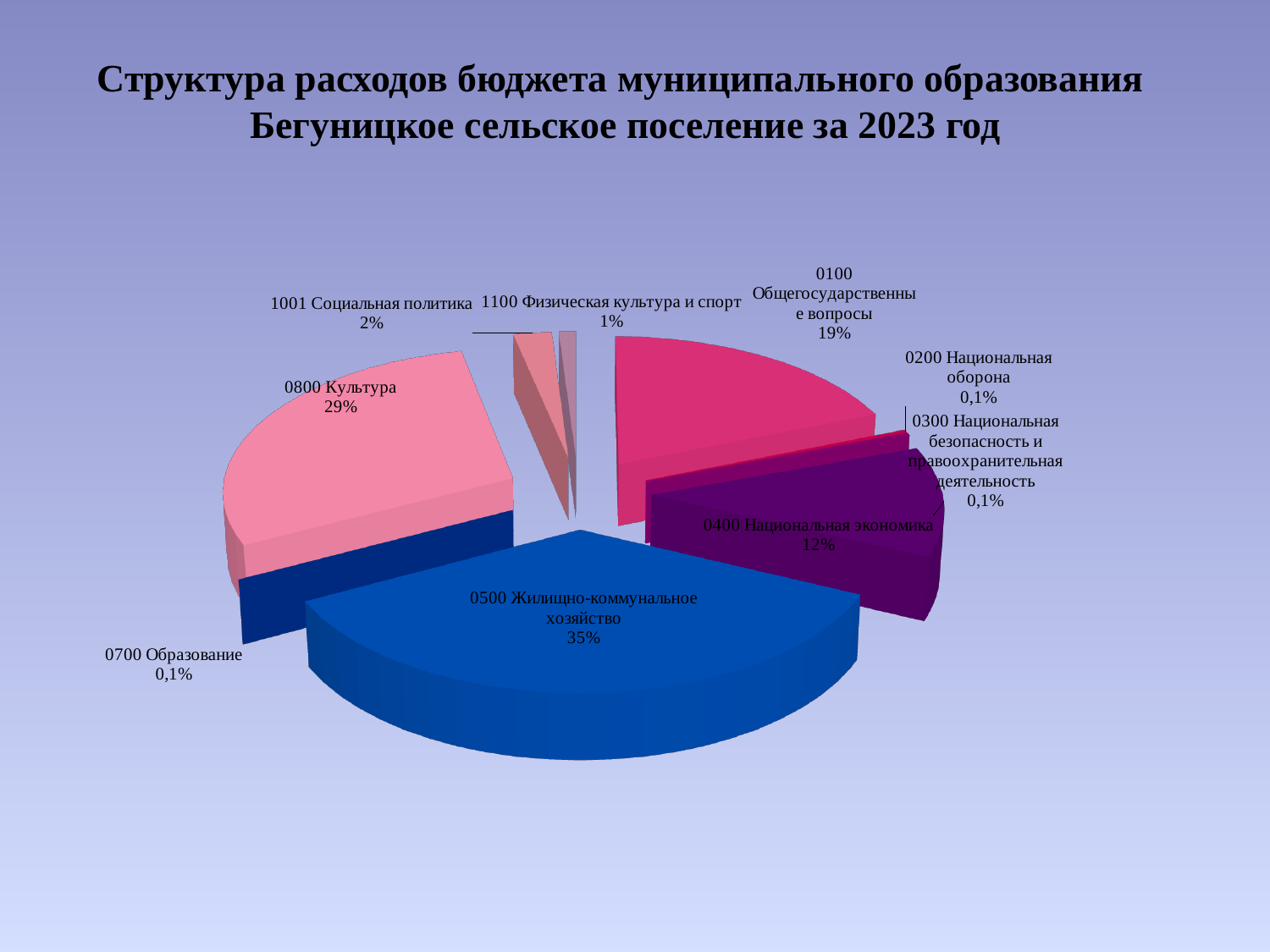
Which category has the largest share of the pie? 0500 Жилищно-коммунальное хозяйство What is the value shown for 0100 Общегосударственные вопросы? 19% What type of chart is shown on the slide? Pie chart What is the value shown for 0200 Национальная оборона? 0,1% What is the value shown for 0800 Культура? 29% What is the title of the slide? Структура расходов бюджета муниципального образования Бегуницкое сельское поселение за 2023 год What share of the pie does 0500 Жилищно-коммунальное хозяйство have? 35% What is the difference between the shares of 0500 Жилищно-коммунальное хозяйство and 0800 Культура? 6% How many categories are shown in the pie chart? 9 What is the value shown for 1001 Социальная политика? 2% What is the value shown for 0400 Национальная экономика? 12% Which is larger, the share of 0100 Общегосударственные вопросы or 0400 Национальная экономика? 0100 Общегосударственные вопросы